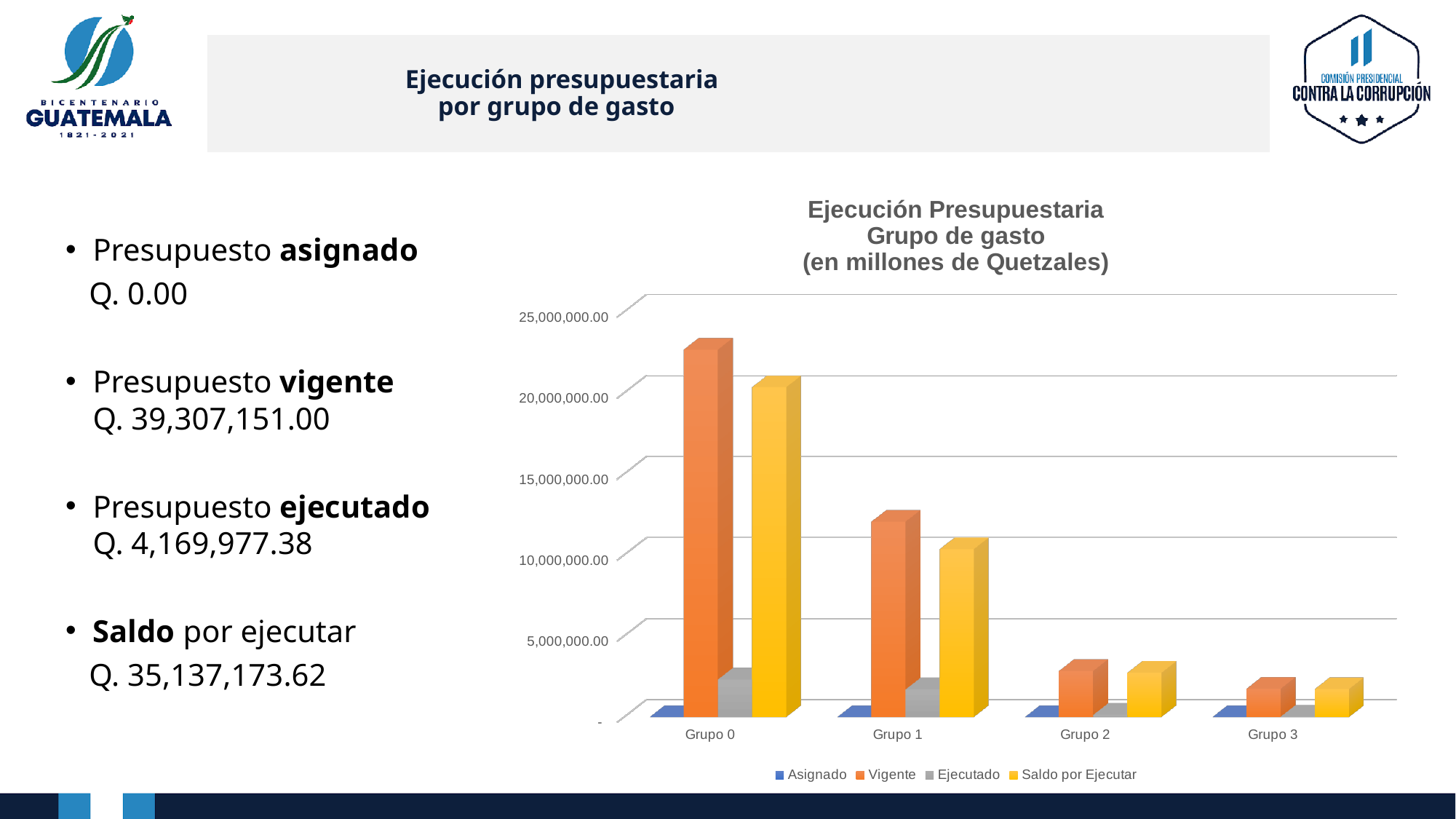
Which group has the highest Vigente value? Grupo 0 Is the Vigente value for Grupo 0 greater or less than 20,000,000.00? greater Which series is shown in yellow in the chart legend? Saldo por Ejecutar Is the Vigente value for Grupo 1 greater or less than 10,000,000.00? greater What kind of chart is shown on the slide? bar chart How many groups (categories) are shown on the x axis of the chart? 4 Which group has the lowest Vigente value? Grupo 3 How many series does the chart legend list? 4 Is the Ejecutado value for Grupo 0 greater or less than 5,000,000.00? less In Grupo 1, which is larger: the Vigente value or the Ejecutado value? Vigente Do the Vigente values rise or fall from Grupo 0 to Grupo 3? fall